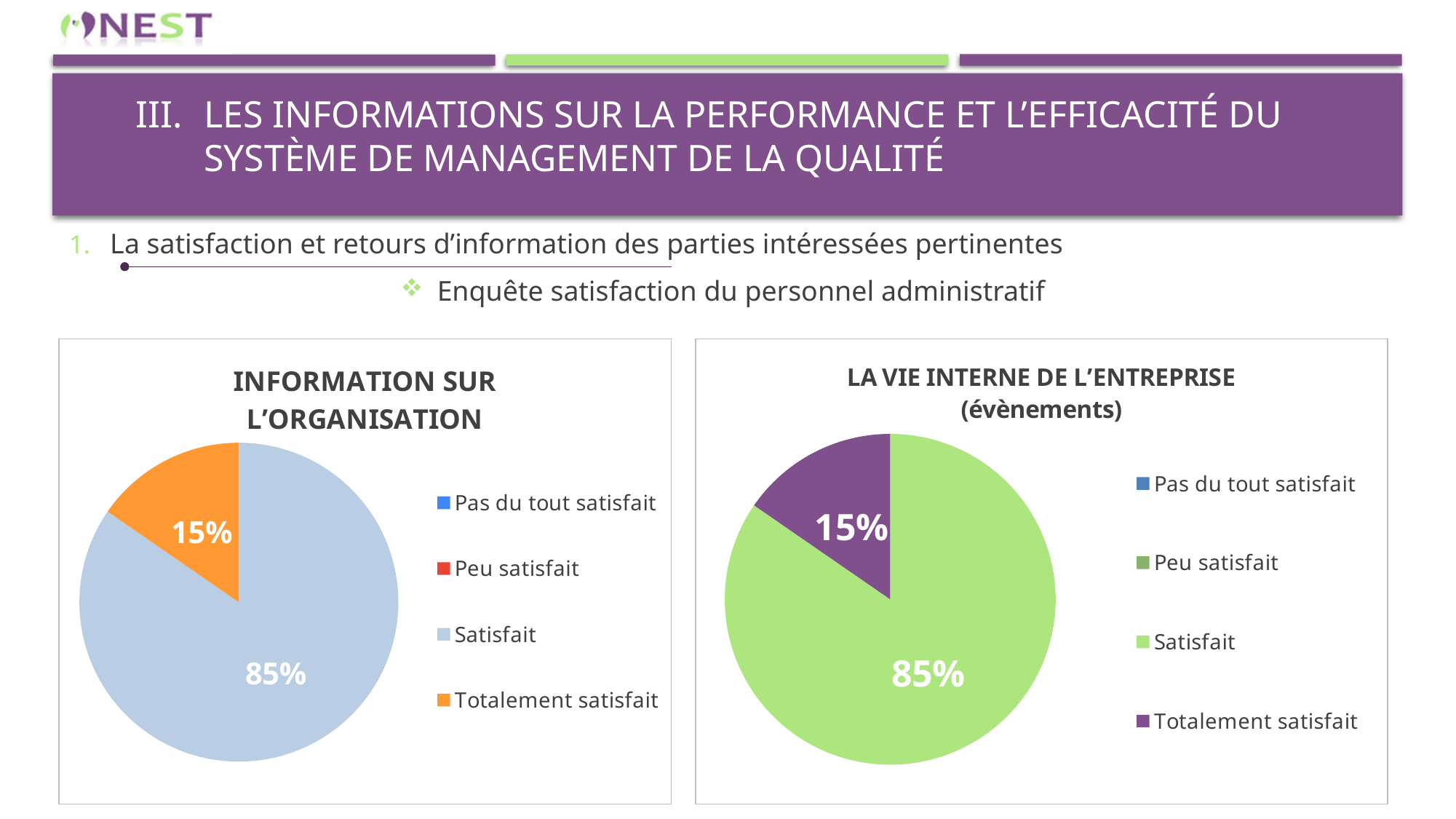
In the 'LA VIE INTERNE DE L'ENTREPRISE (évènements)' chart, which category has the largest slice? Satisfait In the 'LA VIE INTERNE DE L'ENTREPRISE (évènements)' chart, what percentage is shown for Totalement satisfait? 15% In the 'INFORMATION SUR L'ORGANISATION' chart, what colour is the Totalement satisfait slice? Orange In the 'INFORMATION SUR L'ORGANISATION' chart, what percentage is shown for Totalement satisfait? 15% In the 'INFORMATION SUR L'ORGANISATION' chart, which category has the largest slice? Satisfait In the 'INFORMATION SUR L'ORGANISATION' chart, what is the difference in percentage points between Satisfait and Totalement satisfait? 70 In the 'LA VIE INTERNE DE L'ENTREPRISE (évènements)' chart, which is larger, Satisfait or Totalement satisfait? Satisfait In the 'LA VIE INTERNE DE L'ENTREPRISE (évènements)' chart, what colour is the Satisfait slice? Green In the 'LA VIE INTERNE DE L'ENTREPRISE (évènements)' chart, what percentage is shown for Satisfait? 85% How many categories does the legend of the 'LA VIE INTERNE DE L'ENTREPRISE (évènements)' chart list? 4 In the 'INFORMATION SUR L'ORGANISATION' chart, what percentage is shown for Satisfait? 85% What type of chart is 'INFORMATION SUR L'ORGANISATION'? Pie chart